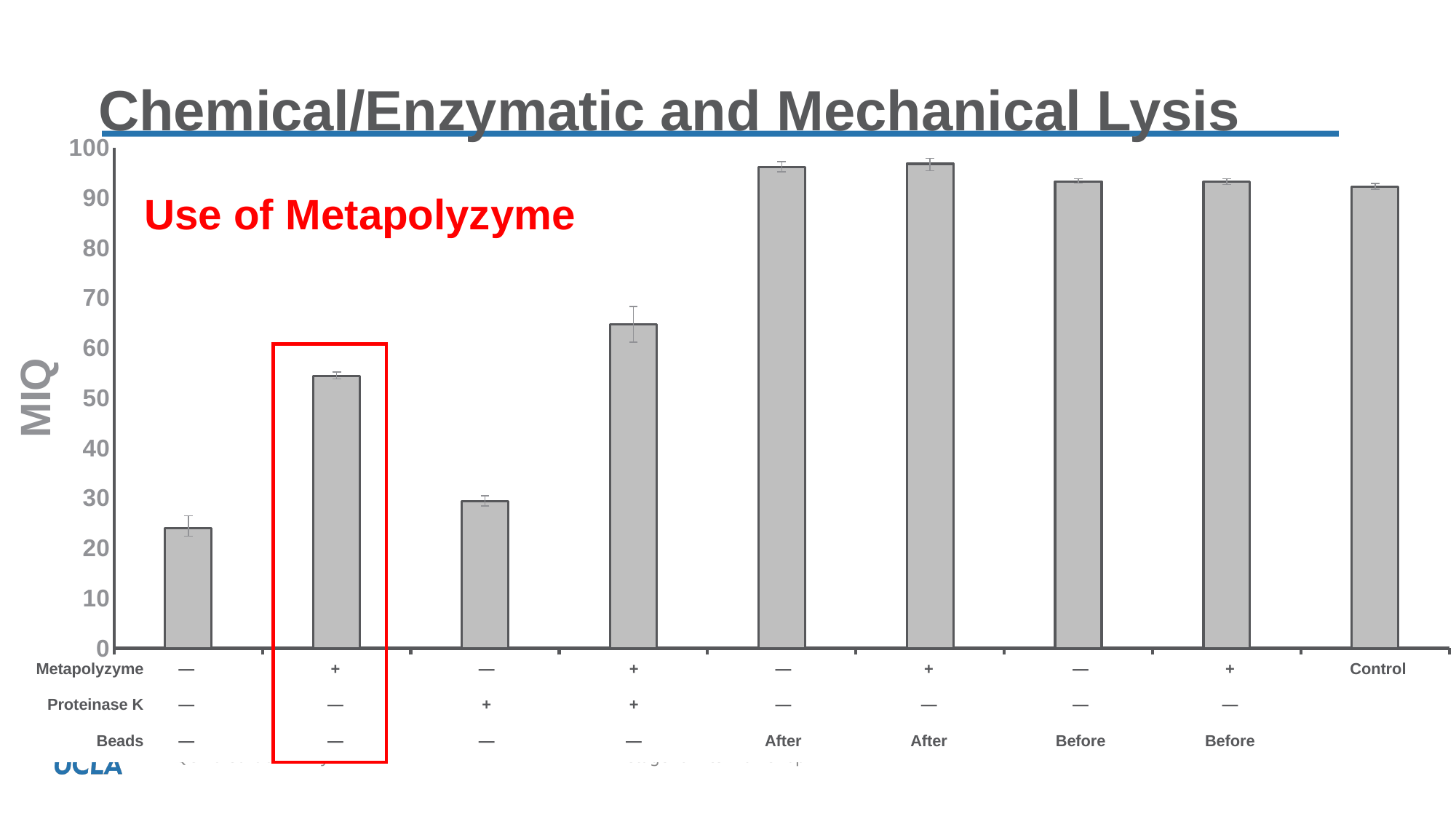
Which bar is highlighted by the red box on the chart? Metapolyzyme +, Proteinase K —, Beads — (the second bar) Is the MIQ value for the bar with Metapolyzyme + and Proteinase K + (no beads) greater or less than 60? greater Which has the higher MIQ value: the bar with Metapolyzyme + only (no Proteinase K, no beads) or the bar with Proteinase K + only (no Metapolyzyme, no beads)? Metapolyzyme + only Which has the higher MIQ value: the bar with Beads After (Metapolyzyme —, Proteinase K —) or the bar with Metapolyzyme + and Proteinase K + (no beads)? Beads After (Metapolyzyme —, Proteinase K —) Is the MIQ value for the Control bar greater or less than 90? greater Is the MIQ value for the first bar (Metapolyzyme —, Proteinase K —, Beads —) greater or less than 30? less What kind of chart is shown on the slide? bar chart Which bar has the lowest MIQ value? Metapolyzyme —, Proteinase K —, Beads — (the first bar) What is the label on the y axis of the chart? MIQ How many bars are plotted in the chart? 9